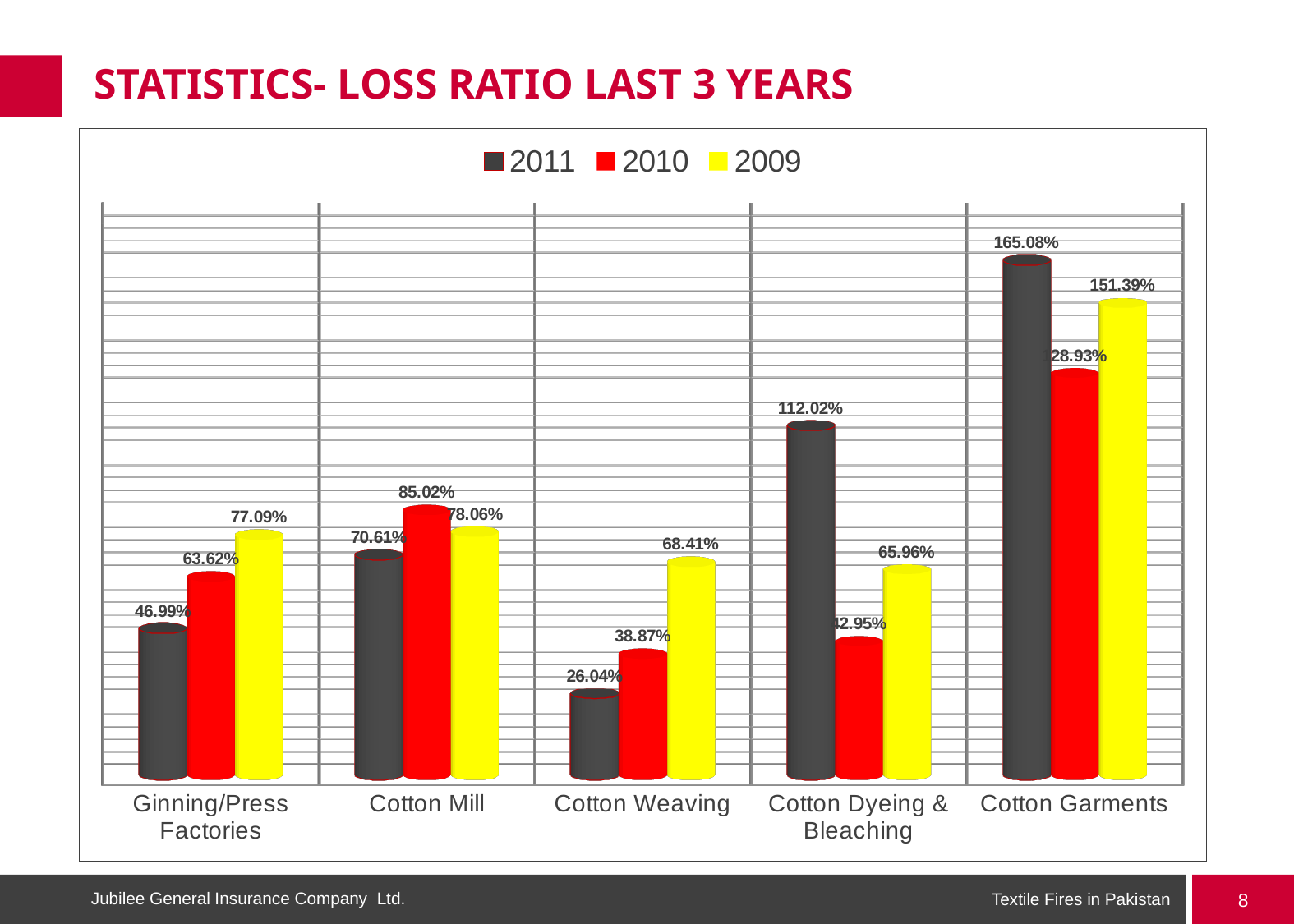
What is the 2010 loss ratio for Cotton Mill? 85.02% Which category has the highest 2009 loss ratio? Cotton Garments What is the 2011 loss ratio for Cotton Dyeing & Bleaching? 112.02% Which category has the lowest 2011 loss ratio? Cotton Weaving Which is larger for Cotton Weaving, the 2010 value or the 2009 value? 2009 How many categories are shown on the x axis? 5 Which colour represents the 2009 series in the legend? yellow What type of chart is shown on the slide? bar chart How many series does the legend list? 3 What is the difference between the 2009 and 2011 loss ratios for Ginning/Press Factories? 30.10% What is the 2011 loss ratio for Cotton Garments? 165.08% What is the 2009 loss ratio for Ginning/Press Factories? 77.09%